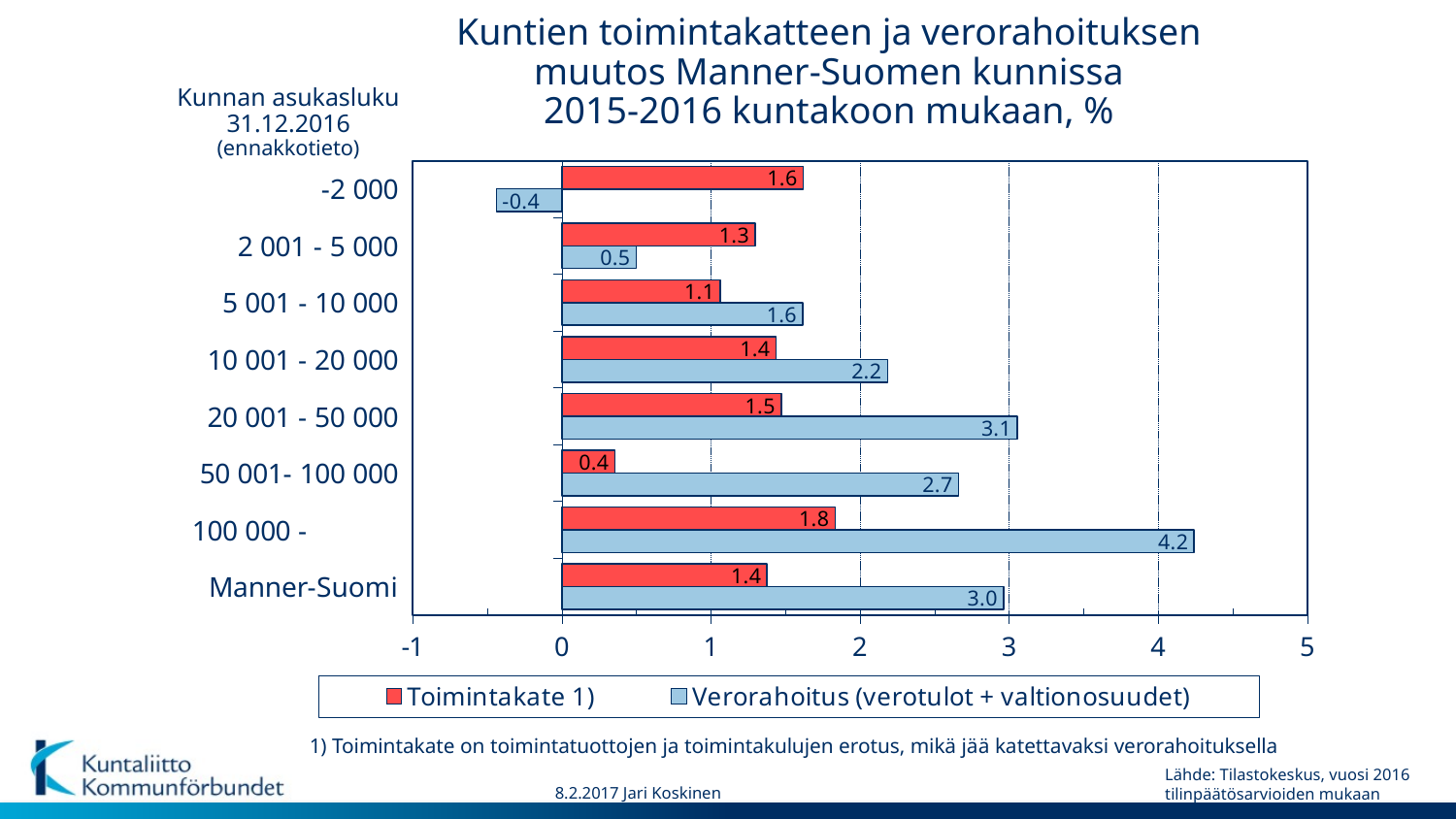
What is the Toimintakate 1) value for Manner-Suomi? 1.4 Is the Verorahoitus (verotulot + valtionosuudet) value for the 50 001- 100 000 category greater or less than 2? greater What is the Verorahoitus (verotulot + valtionosuudet) value for the -2 000 category? -0.4 What is the difference between the Verorahoitus and Toimintakate 1) values for the 20 001 - 50 000 category? 1.6 How many categories are shown on the chart? 8 Which category has the highest Verorahoitus (verotulot + valtionosuudet) value? 100 000 - Which colour represents the Toimintakate 1) series? Red What kind of chart is shown on the slide? Bar chart What is the Verorahoitus (verotulot + valtionosuudet) value for the 100 000 - category? 4.2 Which category has the lowest Toimintakate 1) value? 50 001- 100 000 How many series does the legend list? 2 For the 2 001 - 5 000 category, which is larger: Toimintakate 1) or Verorahoitus (verotulot + valtionosuudet)? Toimintakate 1)